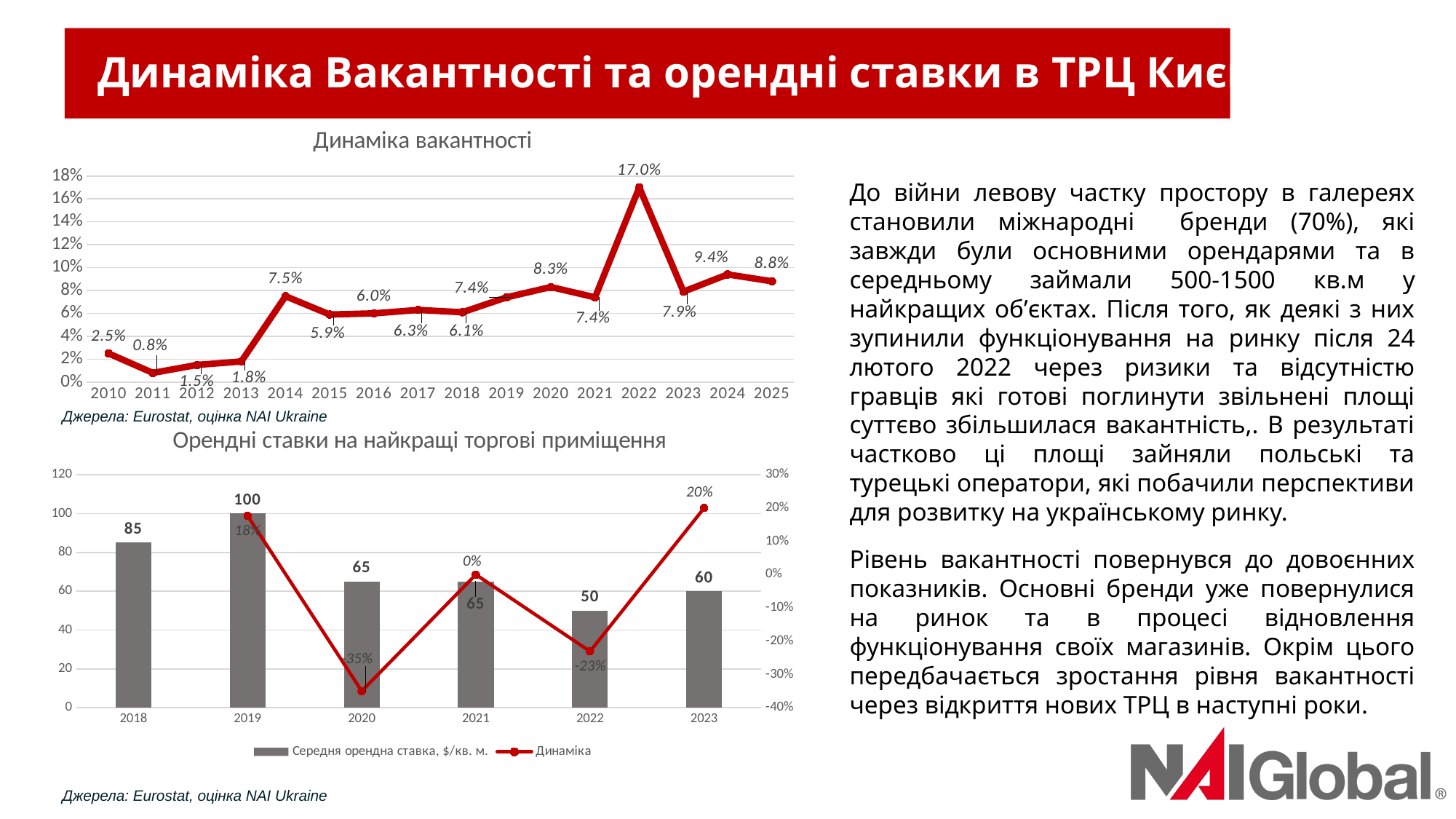
In the 'Динаміка вакантності' chart, which year has the lowest vacancy value? 2011 In the 'Орендні ставки на найкращі торгові приміщення' chart, what is the 'Динаміка' value for 2020? -35% In the 'Орендні ставки на найкращі торгові приміщення' chart, what is the difference between the average rental rate in 2019 and in 2022? 50 In the 'Орендні ставки на найкращі торгові приміщення' chart, what is the average rental rate for 2019? 100 In the 'Орендні ставки на найкращі торгові приміщення' chart, how many series does the legend list? 2 In the 'Динаміка вакантності' chart, what is the vacancy value for 2022? 17.0% In the 'Орендні ставки на найкращі торгові приміщення' chart, is the average rental rate for 2018 larger or smaller than for 2023? larger In the 'Орендні ставки на найкращі торгові приміщення' chart, which year has the lowest average rental rate? 2022 In the 'Динаміка вакантності' chart, what is the vacancy value for 2014? 7.5% In the 'Динаміка вакантності' chart, what is the difference between the 2022 value and the 2023 value? 9.1% In the 'Динаміка вакантності' chart, how many years are plotted on the x axis? 16 In the 'Динаміка вакантності' chart, which year has the highest vacancy value? 2022